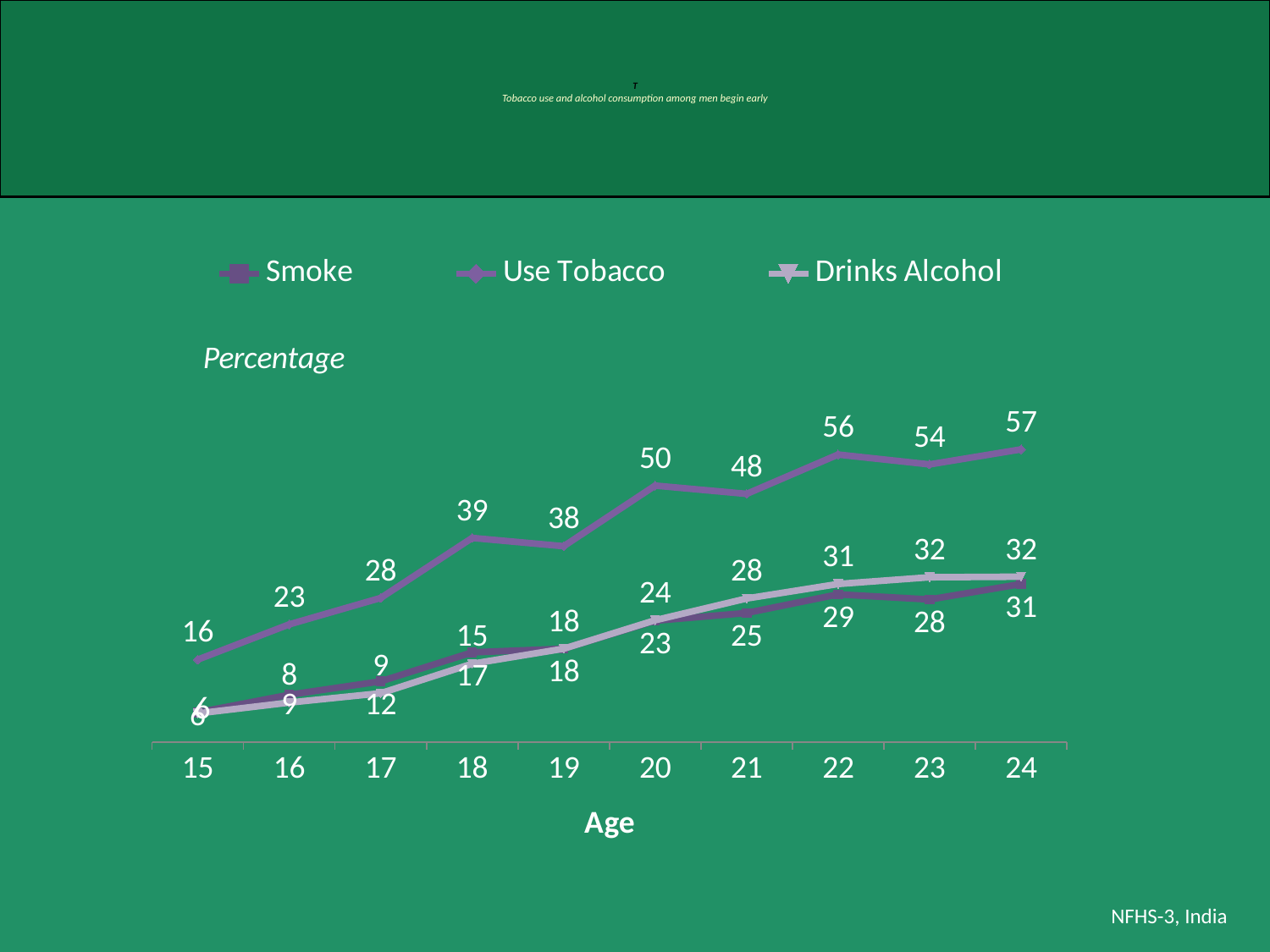
What is the Use Tobacco value at age 20? 50 What is the Use Tobacco value at age 24? 57 How many ages are plotted on the x axis? 10 How many series does the legend list? 3 Does the Use Tobacco line generally rise or fall as age increases from 15 to 24? Rise What is the difference between the Use Tobacco values at age 24 and age 15? 41 What is the Drinks Alcohol value at age 23? 32 What is the Smoke value at age 24? 31 At which age is the Use Tobacco value highest? 24 At age 22, which is larger: Use Tobacco or Smoke? Use Tobacco At which age is the Use Tobacco value lowest? 15 What kind of chart is shown on the slide? Line chart